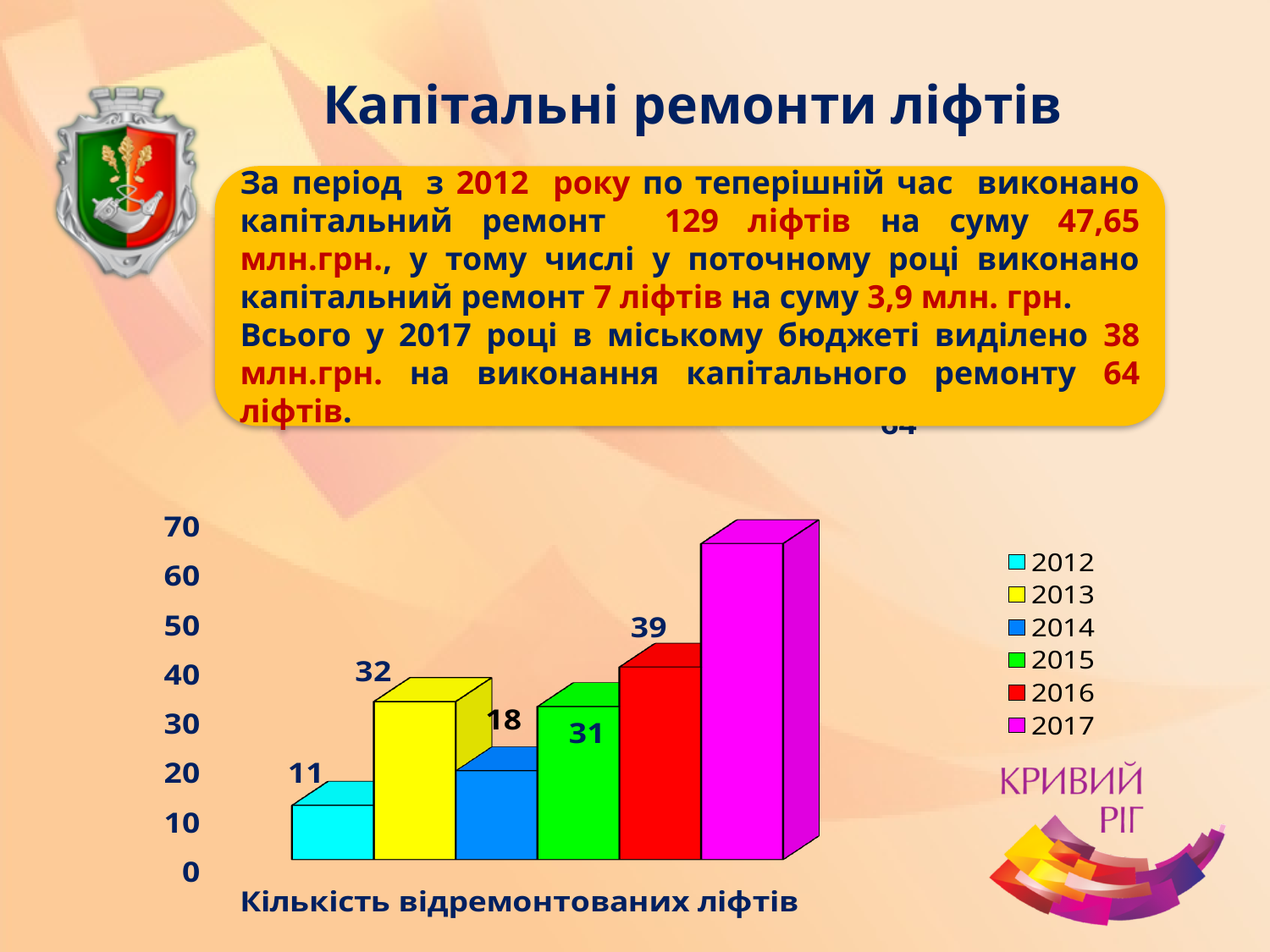
What is the value for 2016 in the chart? 39 What is the difference between the values for 2016 and 2013? 7 Which is larger, the value for 2013 or the value for 2015? 2013 Is the value for 2017 greater or less than 60? greater What is the value for 2014 in the chart? 18 What is the value for 2013 in the chart? 32 How many series does the legend list? 6 What kind of chart is shown on the slide? bar chart What is the value for 2012 in the chart? 11 Which year has the highest value in the chart? 2017 What is the label shown under the bars on the horizontal axis? Кількість відремонтованих ліфтів Which year has the lowest value in the chart? 2012